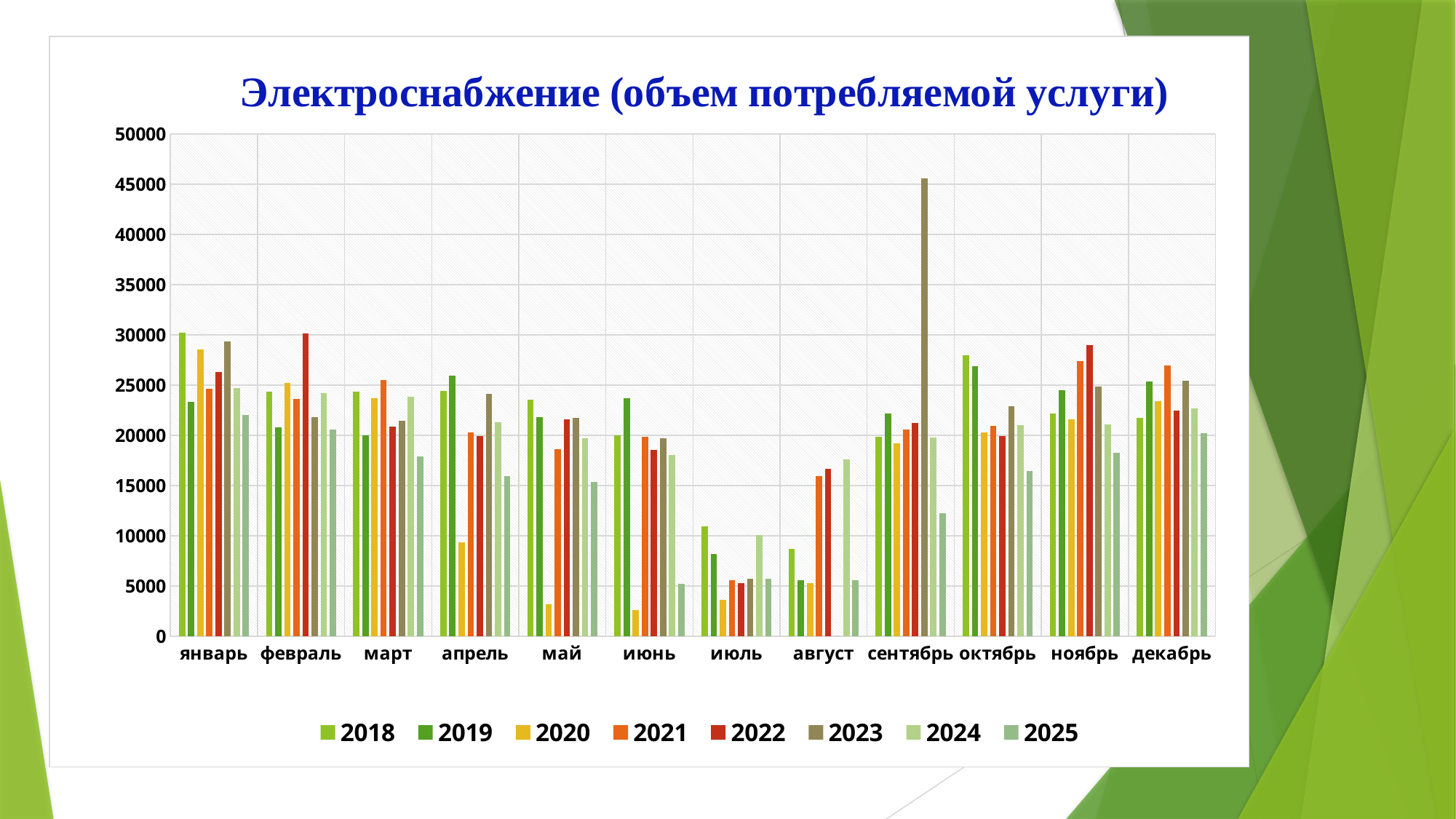
Which series has the tallest bar in the whole chart, and in which month? 2023, сентябрь Is the value for 2025 in сентябрь greater or less than 15000? less In январь, which is larger: the value for 2018 or the value for 2019? 2018 What kind of chart is shown on the slide? bar chart Is the value for 2023 in сентябрь greater or less than 40000? greater How many series does the legend list? 8 Is the value for 2021 in ноябрь greater or less than 25000? greater In июль, which series has the lowest value? 2020 How many months (categories) are shown on the x axis? 12 What is the title of the chart? Электроснабжение (объем потребляемой услуги)